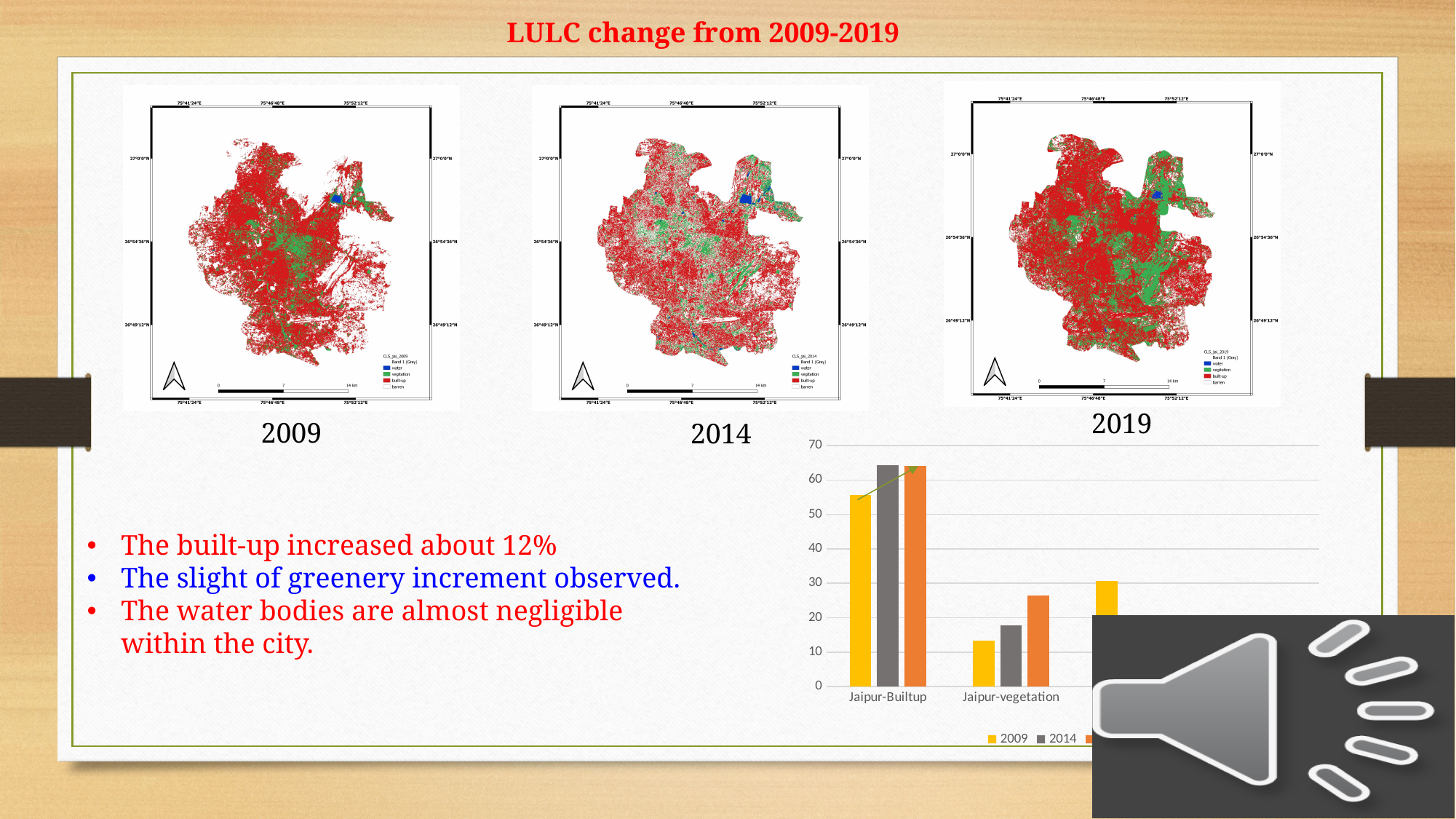
In the bar chart, which category has the lowest 2014 value among the labelled categories? Jaipur-vegetation In the bar chart, is the 2014 value for Jaipur-Builtup greater or less than 60? greater In the bar chart, is the 2009 value for Jaipur-Builtup greater or less than 60? less In the bar chart, what colour are the 2014 bars? grey In the bar chart, is the 2014 value for Jaipur-vegetation greater or less than 20? less In the bar chart, which category has the highest 2009 value? Jaipur-Builtup In the bar chart, which is larger for Jaipur-Builtup: the 2009 value or the 2014 value? 2014 What kind of chart is shown at the bottom right of the slide? bar chart In the bar chart, what is the first entry listed in the legend? 2009 In the bar chart, which is larger: the 2009 value for Jaipur-Builtup or the 2009 value for Jaipur-vegetation? Jaipur-Builtup